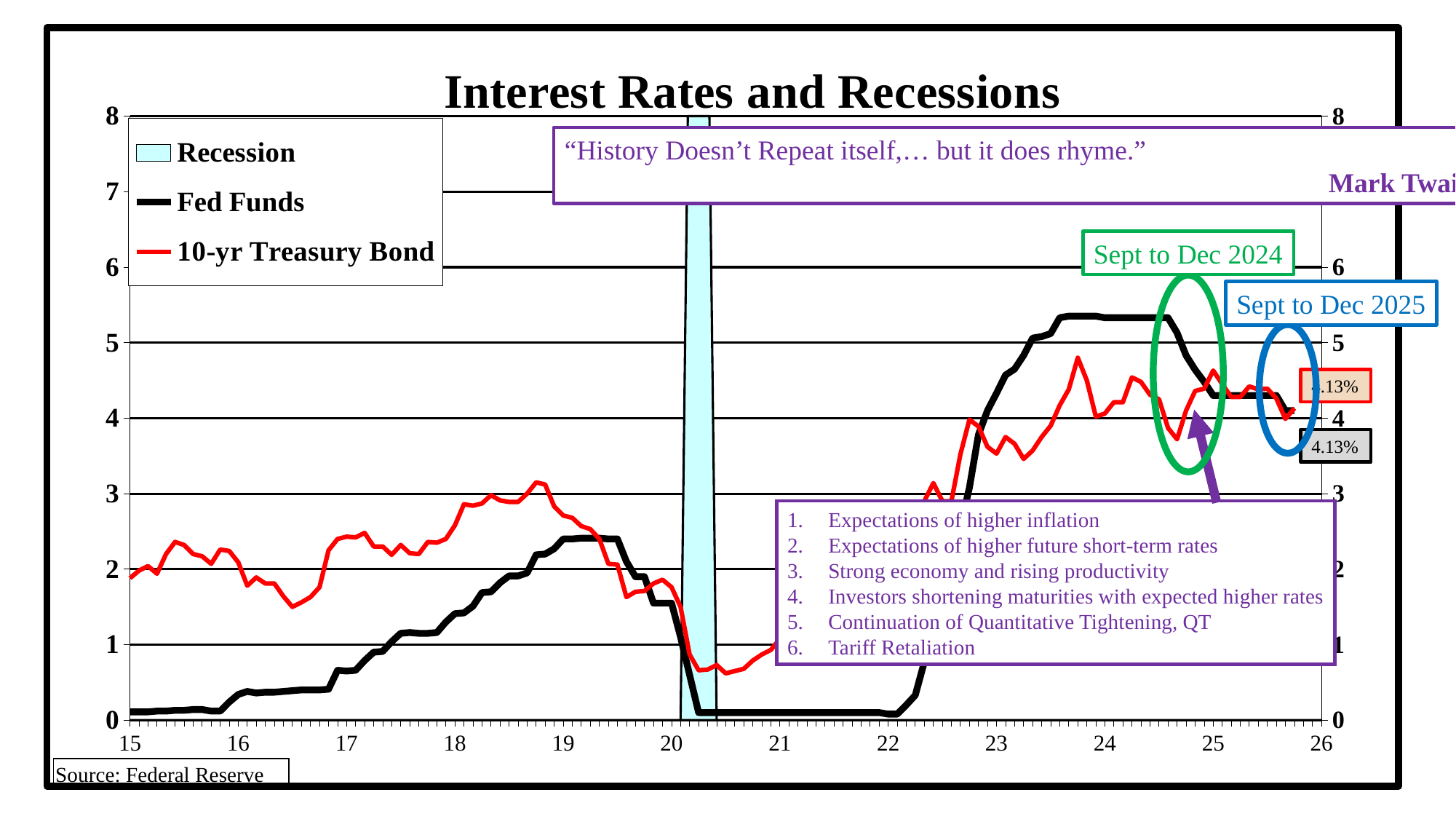
At 21 on the x axis, which series is higher, Fed Funds or 10-yr Treasury Bond? 10-yr Treasury Bond Does the Fed Funds line rise or fall between 24.5 and 25 on the x axis? fall Is the 10-yr Treasury Bond value at 24 on the x axis greater or less than 3? greater Is the Fed Funds value at 21 on the x axis greater or less than 1? less How many entries does the chart's legend list? 3 Does the Fed Funds line rise or fall between 22 and 23 on the x axis? rise What is the title of the chart? Interest Rates and Recessions At 24 on the x axis, which series is higher, Fed Funds or 10-yr Treasury Bond? Fed Funds What kind of chart is shown on the slide? line chart Is the 10-yr Treasury Bond value at 16.5 on the x axis greater or less than 2? less What source is cited for the chart's data? Federal Reserve